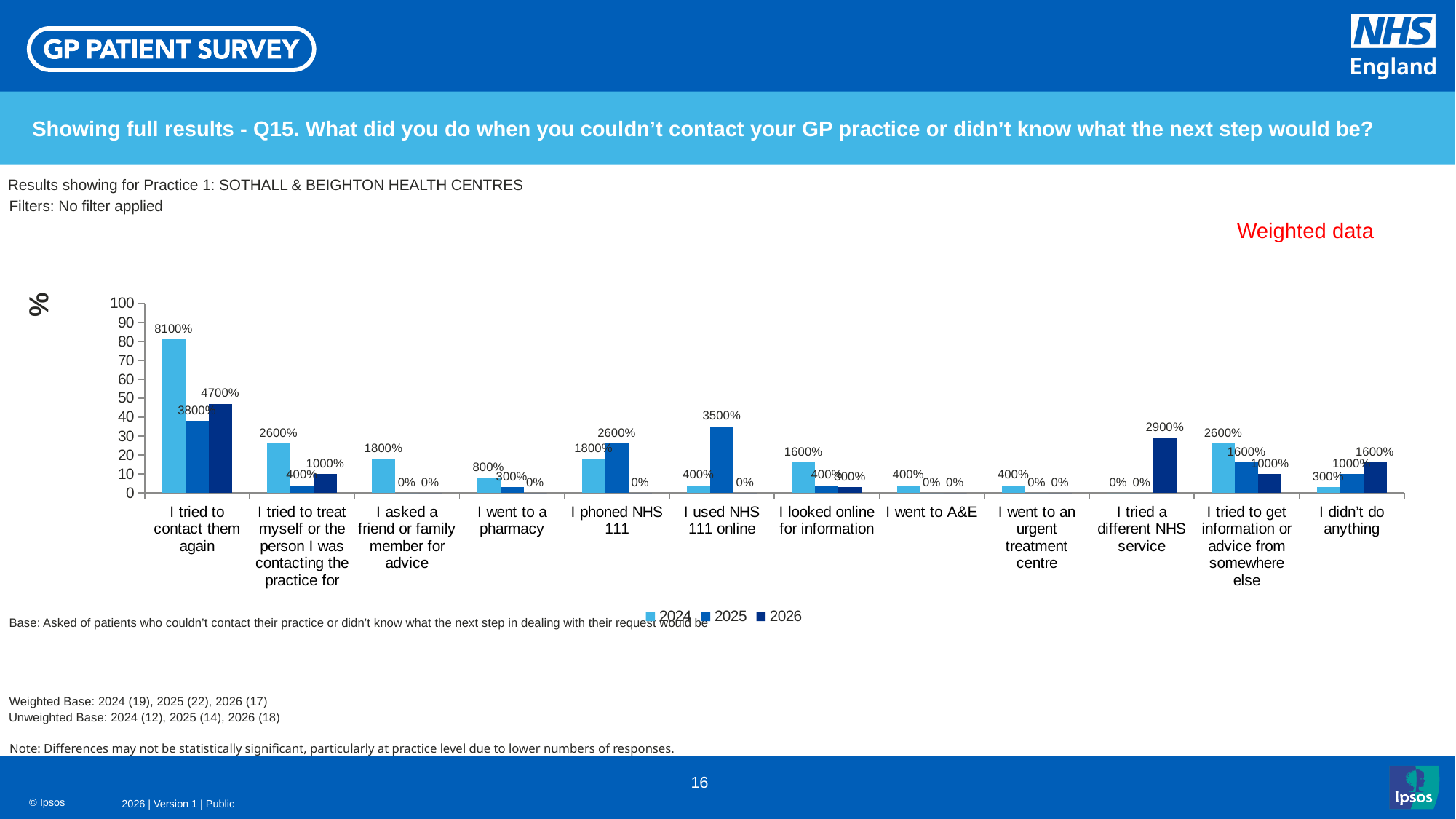
Which is larger for 'I phoned NHS 111': the 2024 value or the 2025 value? 2025 Which category has the highest 2024 value? I tried to contact them again What is the 2024 value for 'I tried to contact them again'? 8100% What kind of chart is shown on the slide? bar chart What is the difference between the 2024 and 2026 values for 'I tried to get information or advice from somewhere else'? 1600% What is the 2025 value for 'I used NHS 111 online'? 3500% Which series is shown in the lightest blue colour in the legend? 2024 What is the 2026 value for 'I tried a different NHS service'? 2900% How many categories are shown on the x axis? 12 What is the 2026 value for 'I didn't do anything'? 1600% How many series does the legend list? 3 Is the 2026 bar for 'I tried to contact them again' above or below the 40 mark on the axis? above